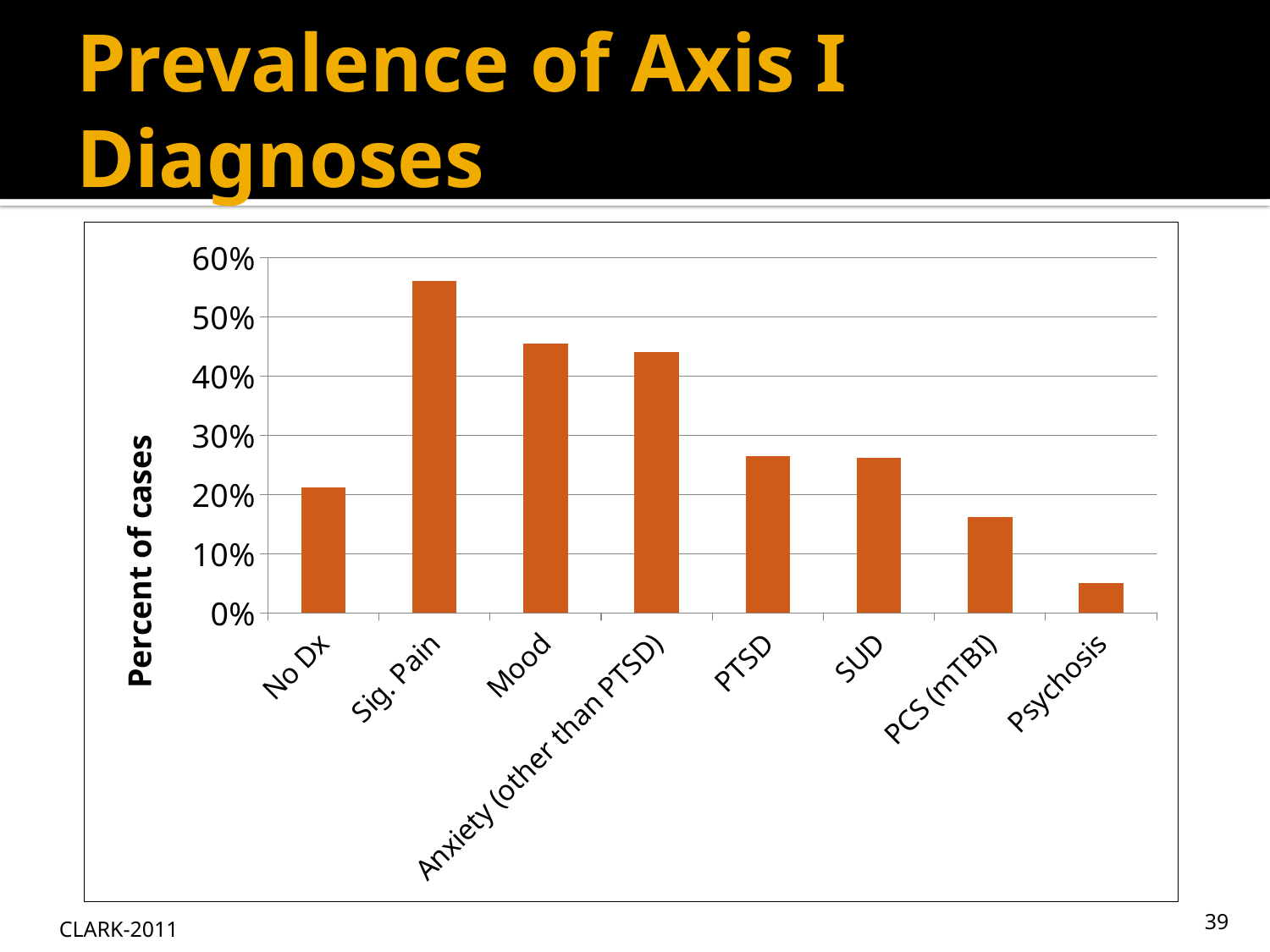
Which category has the highest percent of cases? Sig. Pain Is the value for Sig. Pain greater or less than 50%? greater How many diagnosis categories are plotted on the chart? 8 Which category has the lowest percent of cases? Psychosis What is the label on the vertical axis of the chart? Percent of cases What kind of chart is shown on the slide? bar chart Is the value for Psychosis greater or less than 10%? less Is the value for No Dx greater or less than 30%? less Which is larger, the value for Sig. Pain or the value for Mood? Sig. Pain Which is larger, the value for PTSD or the value for PCS (mTBI)? PTSD